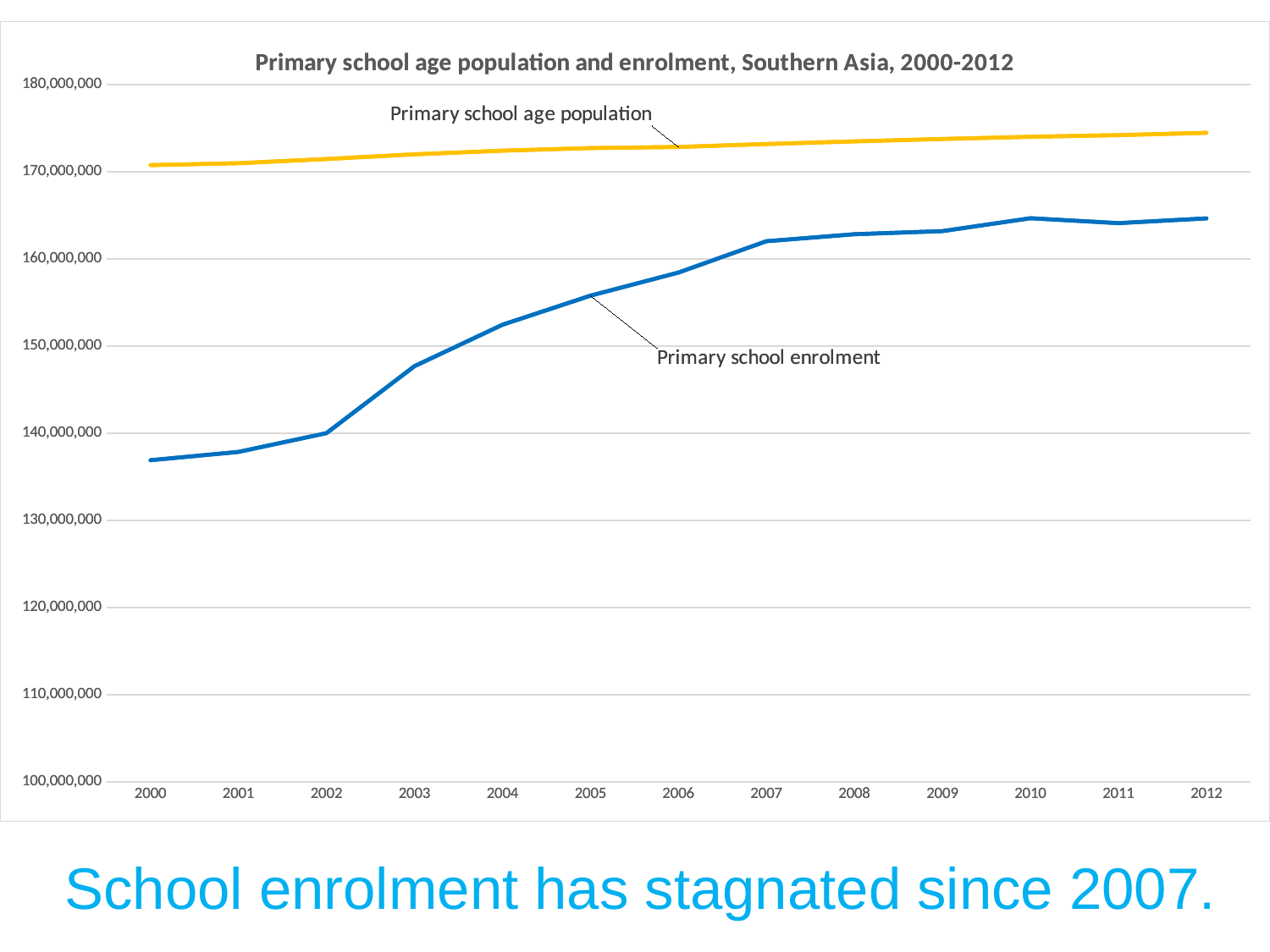
Is the value for Primary school age population in 2012 greater or less than 180,000,000? less How many series are plotted on the chart? 2 How many years are shown on the x axis of the chart? 13 Does Primary school enrolment generally rise or fall from 2000 to 2007? rise Is the value for Primary school enrolment in 2007 greater or less than 160,000,000? greater Is the value for Primary school enrolment in 2000 greater or less than 140,000,000? less In which year is Primary school enrolment lowest? 2000 Which series is drawn in yellow? Primary school age population What kind of chart is shown on the slide? line chart Which series has the larger value in 2005, Primary school age population or Primary school enrolment? Primary school age population What is the title of the chart? Primary school age population and enrolment, Southern Asia, 2000-2012